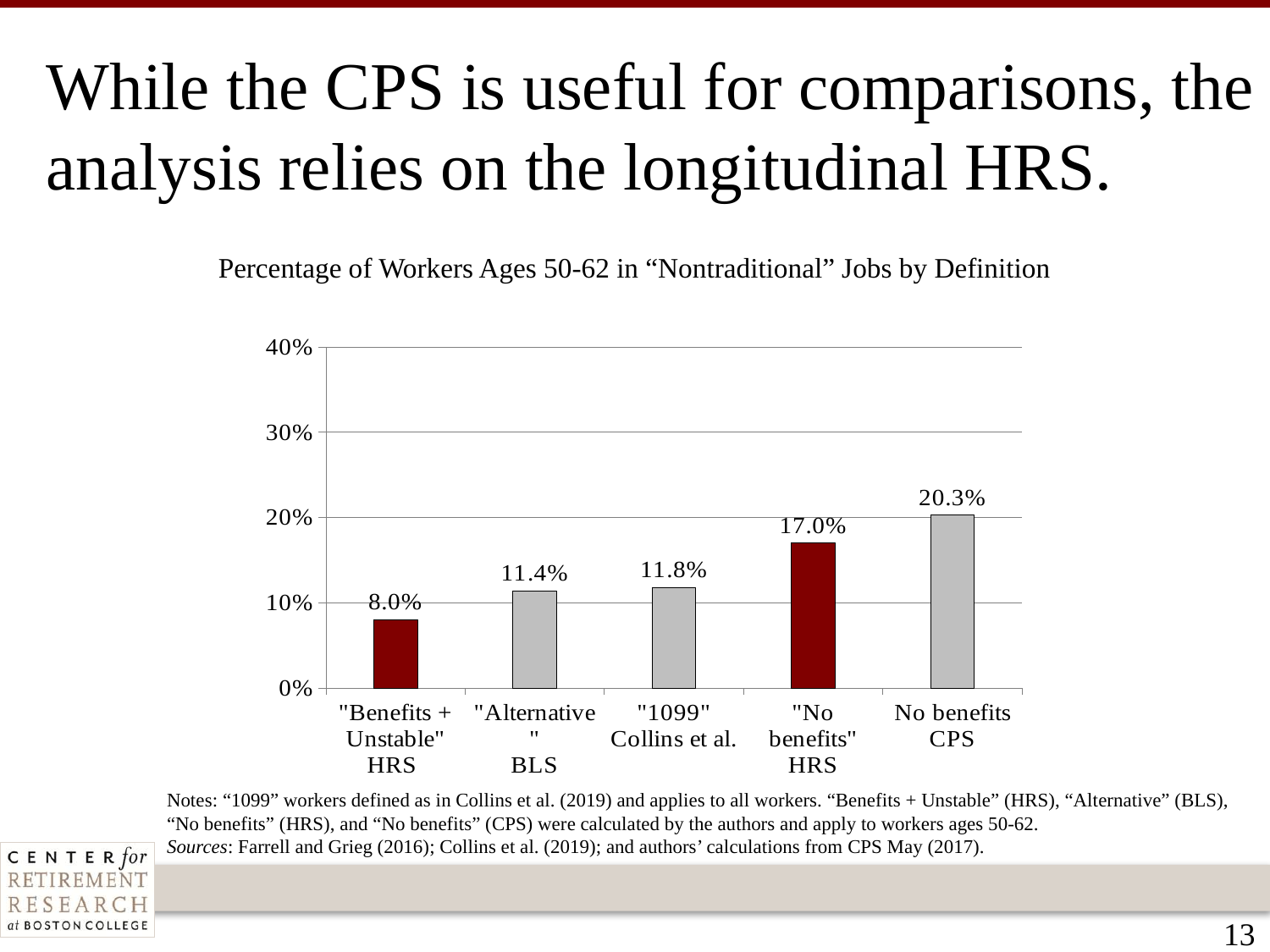
What is the title of the chart? Percentage of Workers Ages 50-62 in "Nontraditional" Jobs by Definition Which category has the highest value? No benefits CPS Which category has the lowest value? "Benefits + Unstable" HRS What is the value for "Benefits + Unstable" HRS? 8.0% What is the value for No benefits CPS? 20.3% What is the difference between No benefits CPS and "No benefits" HRS? 3.3% Which is larger, the value for "No benefits" HRS or the value for "Alternative" BLS? "No benefits" HRS What is the value for "Alternative" BLS? 11.4% What is the value for "1099" Collins et al.? 11.8% What kind of chart is shown on the slide? Bar chart How many categories are shown on the chart? 5 What is the value for "No benefits" HRS? 17.0%